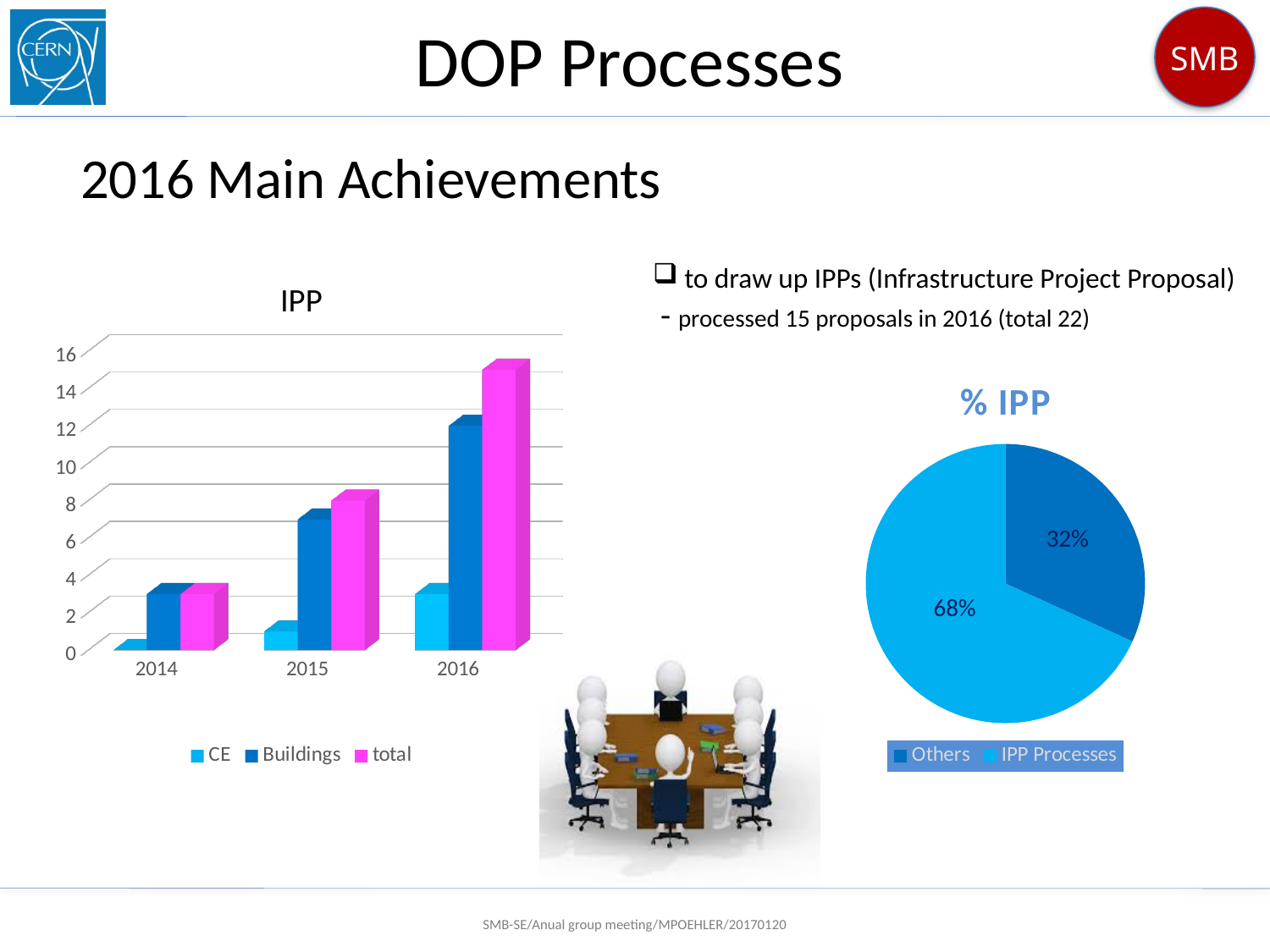
In the IPP bar chart, is the value for CE in 2014 greater or less than 2? less What kind of chart is the % IPP chart on the right? pie chart In the % IPP pie chart, what share is Others? 32% In the IPP bar chart, is the value for total in 2016 greater or less than 10? greater In the IPP bar chart, does the total series rise or fall from 2014 to 2016? rise In the IPP bar chart, how many series does the legend list? 3 In the IPP bar chart, which year has the highest total? 2016 What kind of chart is the IPP chart on the left? bar chart In the IPP bar chart, is the value for Buildings in 2015 greater or less than 4? greater In the % IPP pie chart, what is the difference between the IPP Processes share and the Others share? 36% In the % IPP pie chart, what share is IPP Processes? 68% In the IPP bar chart, how many years are shown on the x axis? 3